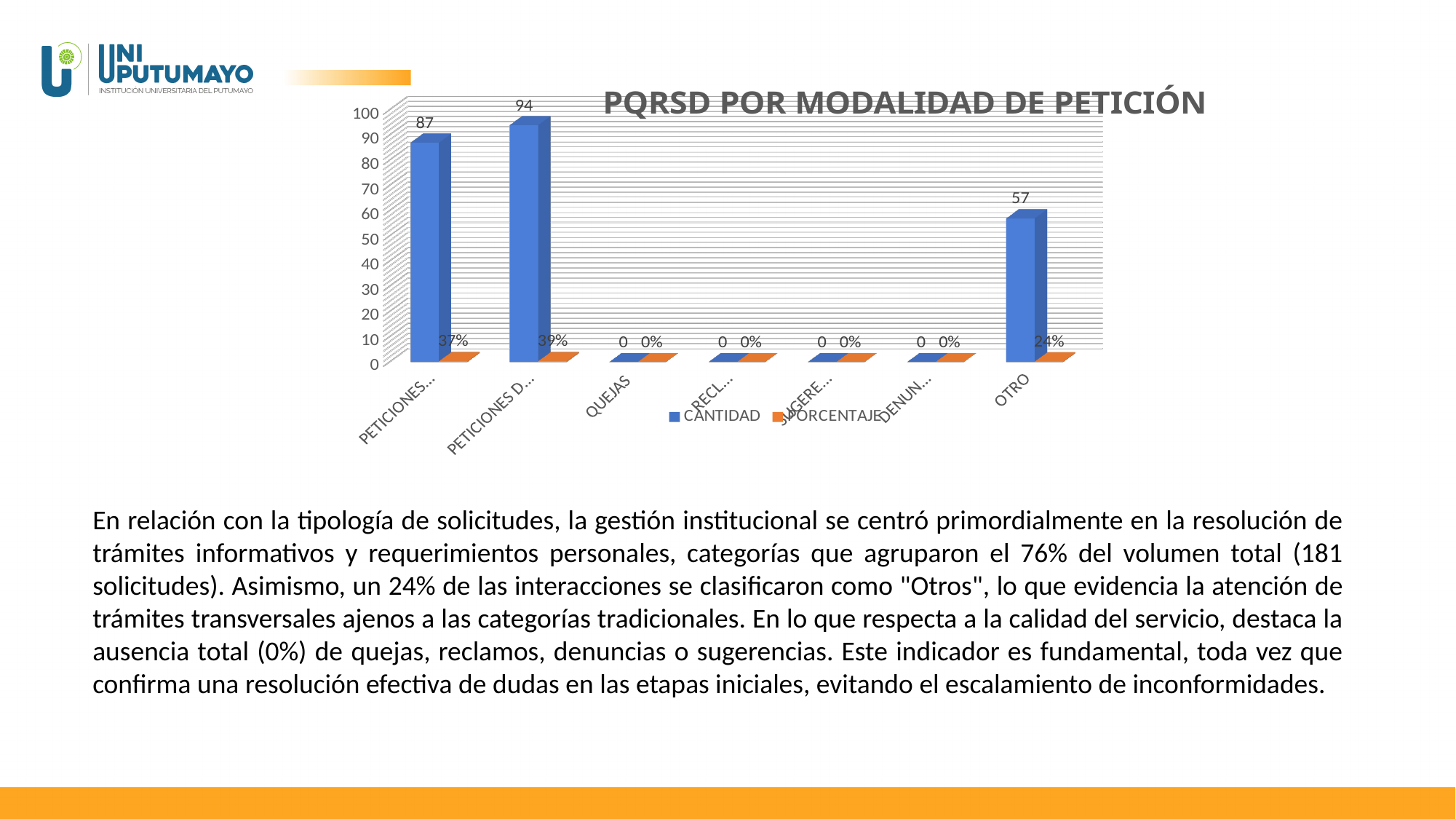
What is the CANTIDAD value for OTRO? 57 What is the difference between the two highest CANTIDAD values (94 and 87)? 7 How many categories are shown along the x axis of the chart? 7 What kind of chart is shown on the slide? Bar chart What is the highest CANTIDAD value shown in the chart? 94 Which has a larger CANTIDAD value: the first category on the left (PETICIONES...) or OTRO? The first category (PETICIONES...) Is the CANTIDAD value for OTRO greater or less than 50? greater How many series does the chart legend list? 2 What is the title of the chart? PQRSD POR MODALIDAD DE PETICIÓN What is the CANTIDAD value for QUEJAS? 0 What are the two series named in the legend? CANTIDAD and PORCENTAJE What is the PORCENTAJE value for OTRO? 24%